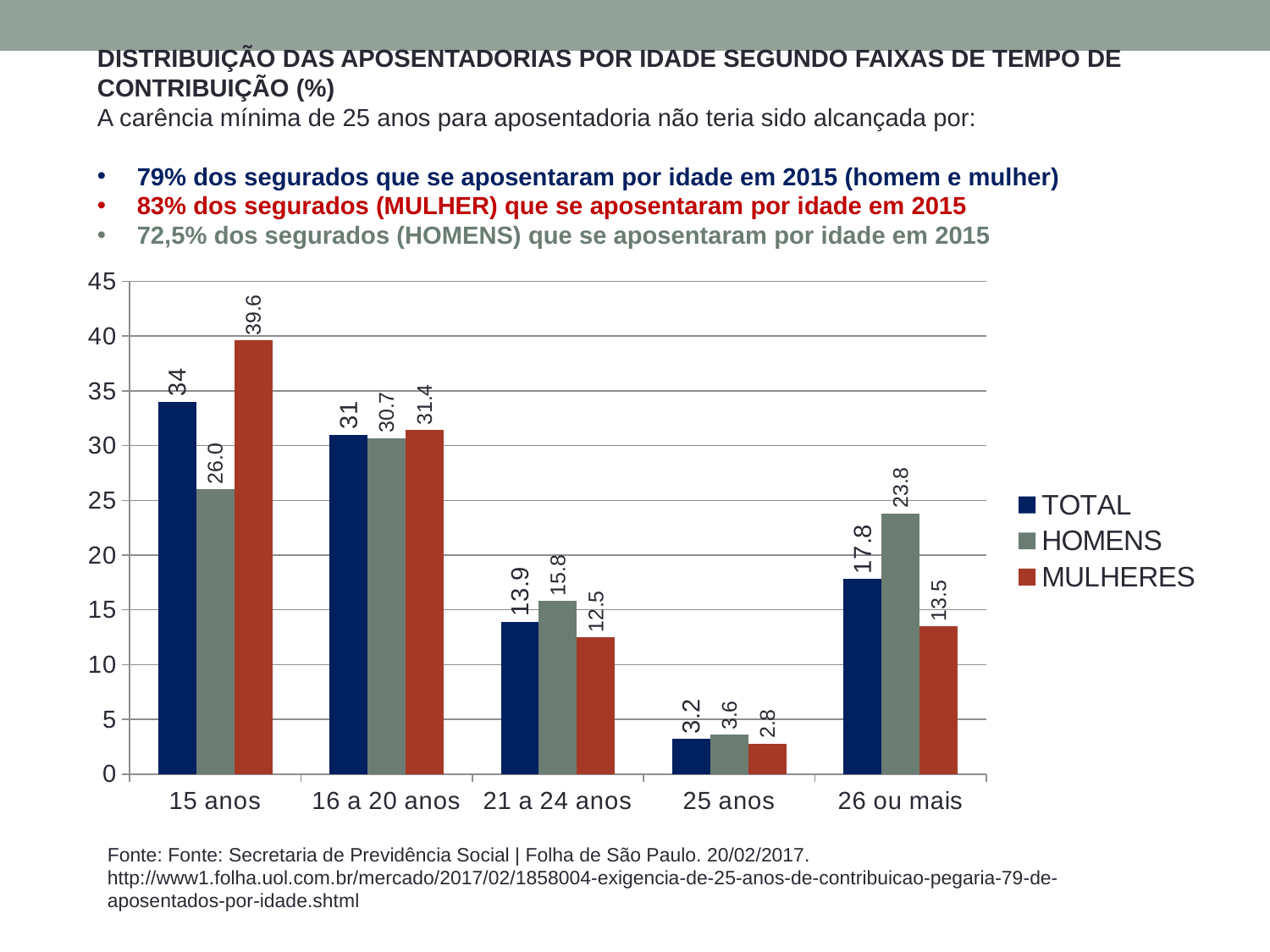
What is the value for HOMENS in the 26 ou mais category? 23.8 What is the value for MULHERES in the 15 anos category? 39.6 Which category has the lowest TOTAL value? 25 anos What is the difference between the MULHERES and HOMENS values in the 15 anos category? 13.6 How many series does the legend list? 3 What is the TOTAL value for the 21 a 24 anos category? 13.9 Which category has the highest MULHERES value? 15 anos Which is larger in the 26 ou mais category, HOMENS or MULHERES? HOMENS Which series is shown in red in the legend? MULHERES How many categories are shown on the x axis? 5 Is the TOTAL value for 16 a 20 anos greater or less than 30? greater What kind of chart is shown on the slide? bar chart